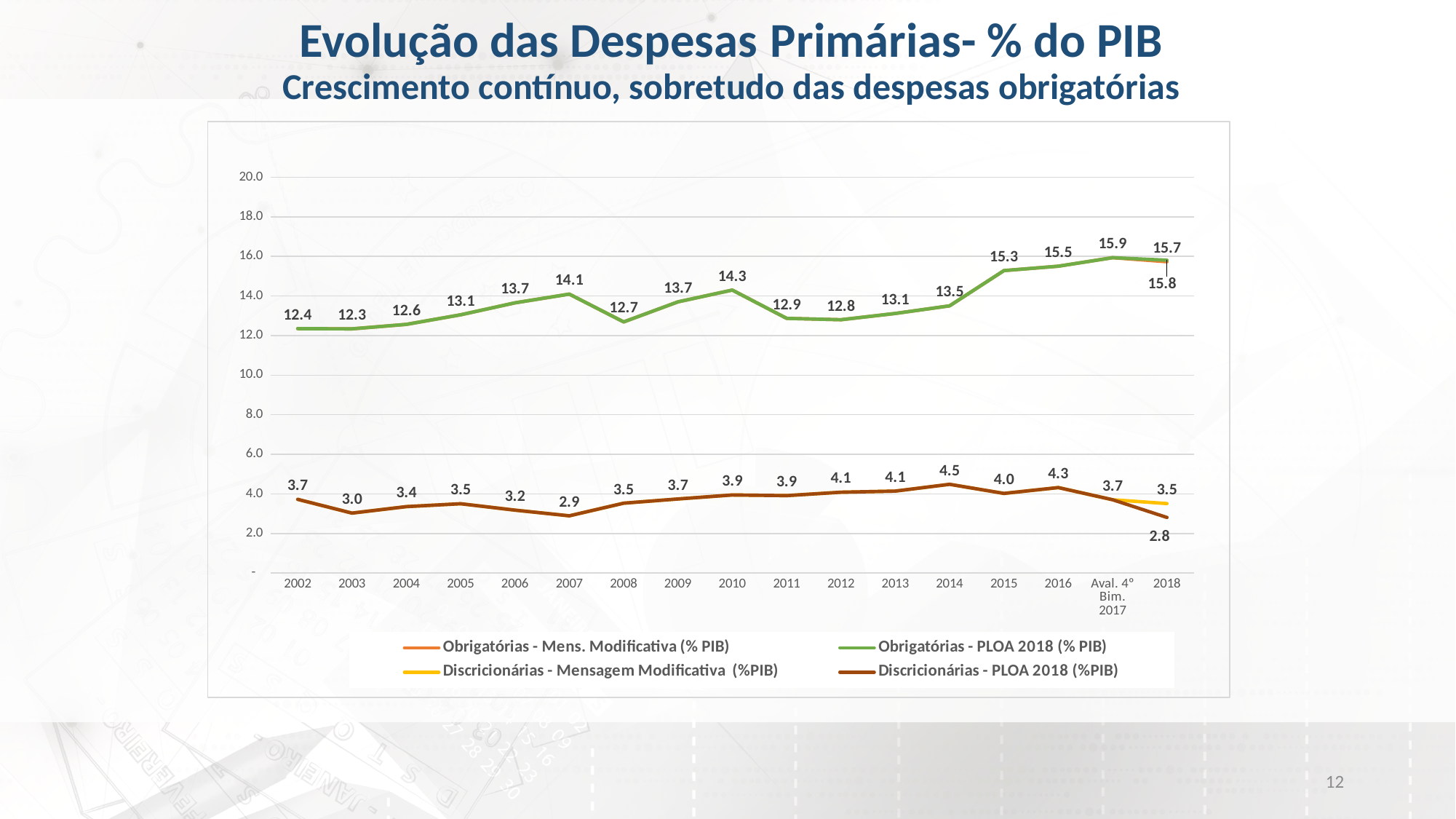
What is the value of Discricionárias - PLOA 2018 (%PIB) in 2014? 4.5 In which period does the Obrigatórias - PLOA 2018 (% PIB) series reach its highest value? Aval. 4º Bim. 2017 What type of chart is shown on the slide? line chart In which year does the Discricionárias - PLOA 2018 (%PIB) series reach its lowest value? 2018 What is the value of Obrigatórias - PLOA 2018 (% PIB) in 2010? 14.3 How many series does the legend list? 4 For Discricionárias - PLOA 2018 (%PIB), which year has the larger value, 2015 or 2016? 2016 What is the difference between the Obrigatórias - PLOA 2018 (% PIB) values for 2007 and 2008? 1.4 Is the value of Obrigatórias - PLOA 2018 (% PIB) in 2015 greater or less than 14.0? greater How many periods are shown on the x axis? 17 What is the value of Discricionárias - Mensagem Modificativa (%PIB) in 2018? 3.5 What is the value of Obrigatórias - PLOA 2018 (% PIB) in 2002? 12.4